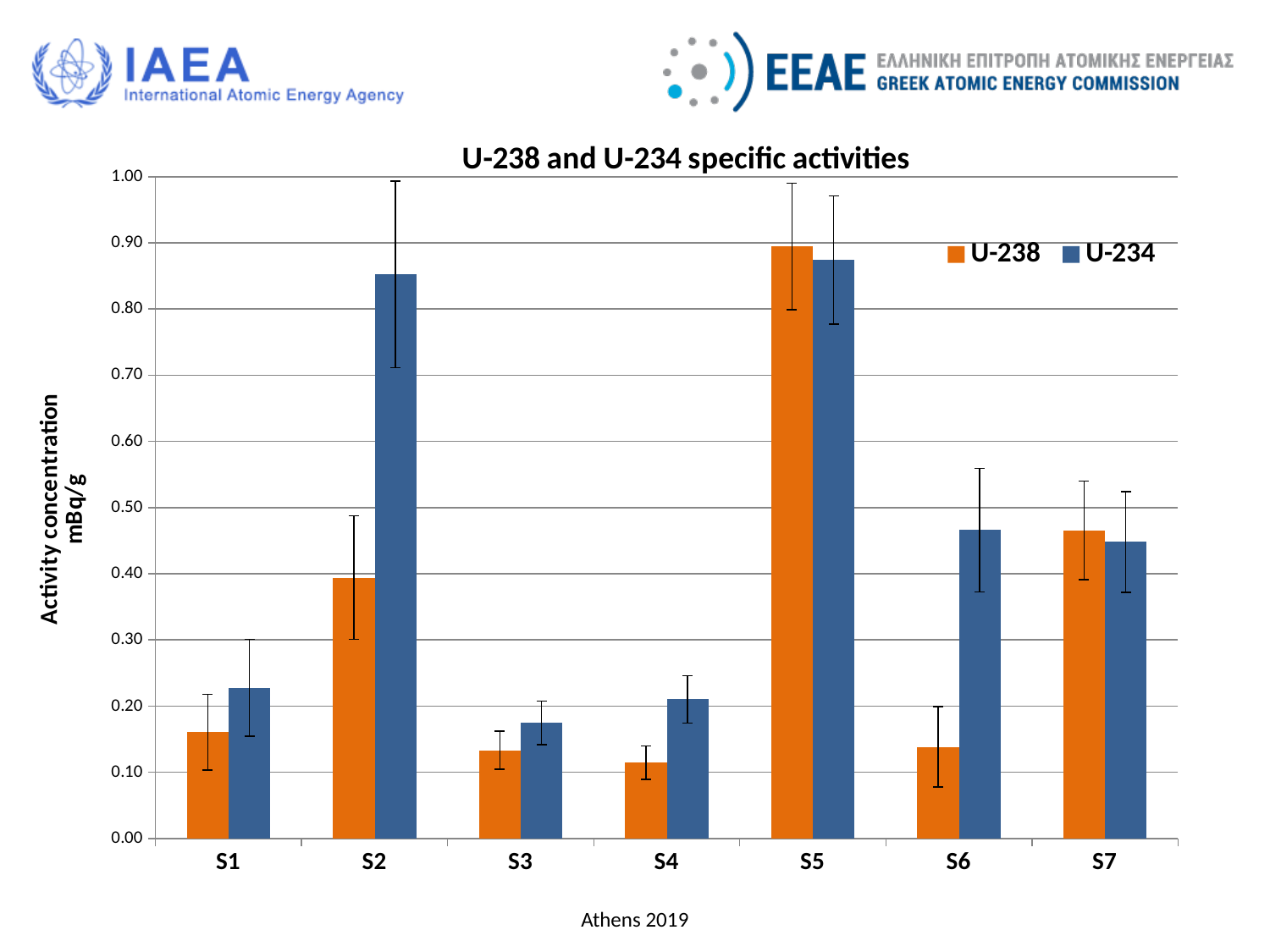
Is the U-234 value for S6 greater or less than 0.50? less How many series does the legend list? 2 Which sample has the highest U-238 value? S5 How many sample categories are shown on the x axis? 7 For S6, which is larger, the U-238 value or the U-234 value? U-234 What kind of chart is shown on the slide? bar chart Is the U-238 value for S1 greater or less than 0.20? less What is the title of the chart? U-238 and U-234 specific activities Is the U-238 value for S5 greater or less than 0.80? greater For S2, which is larger, the U-238 value or the U-234 value? U-234